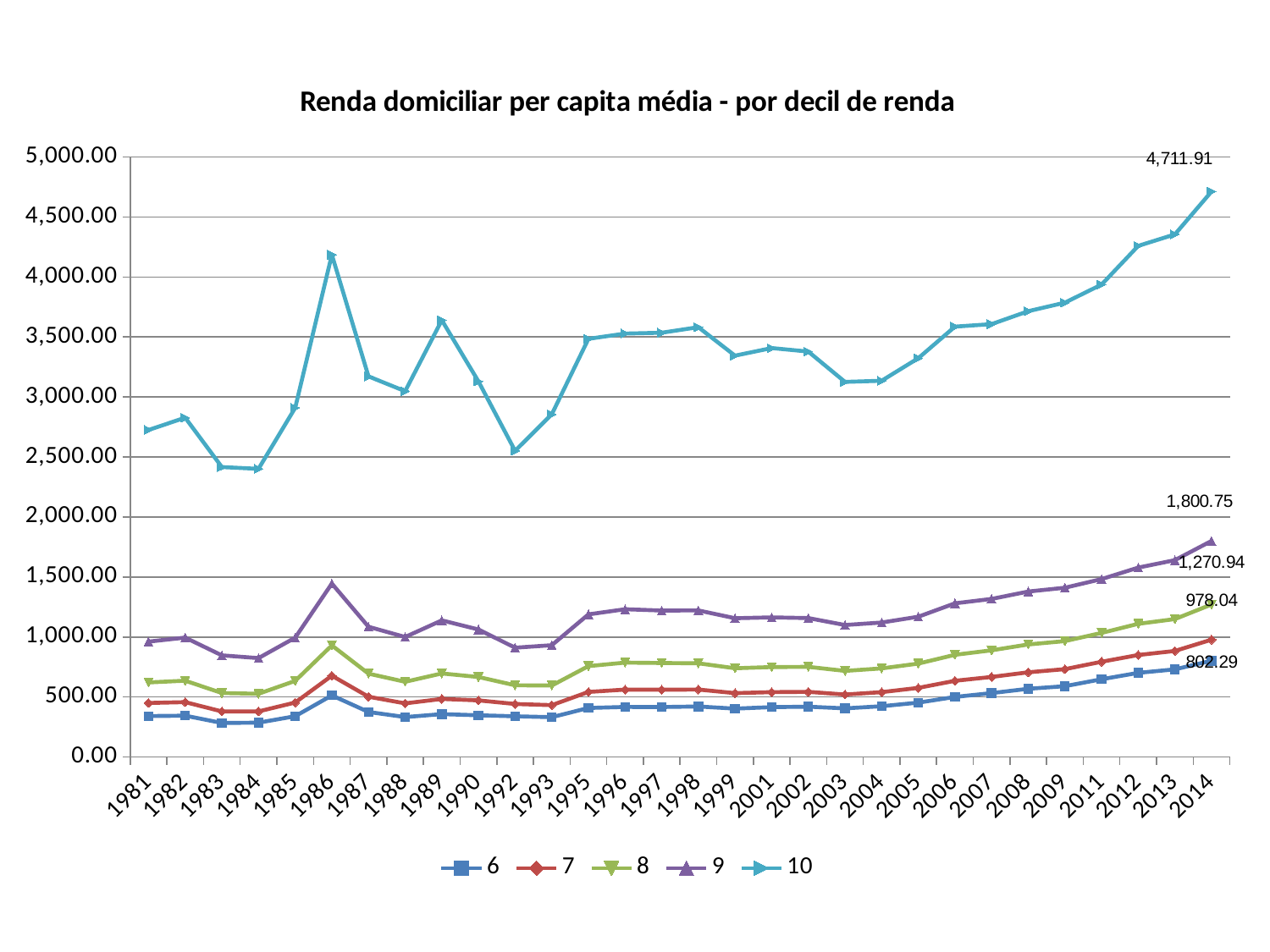
Is the value for series 10 in 1986 greater or less than 4,000? greater What is the value for series 9 in 2014? 1,800.75 How many series does the legend list? 5 Is the value for series 10 in 1983 greater or less than 2,500? less How many years are plotted along the x axis? 30 What is the value for series 10 in 2014? 4,711.91 What is the value for series 6 in 2014? 802.29 What is the title of the chart? Renda domiciliar per capita média - por decil de renda What kind of chart is shown on the slide? line chart What is the difference between series 10 and series 9 in 2014? 2,911.16 Which series has the highest value in 2014? 10 What is the difference between series 8 and series 7 in 2014? 292.90